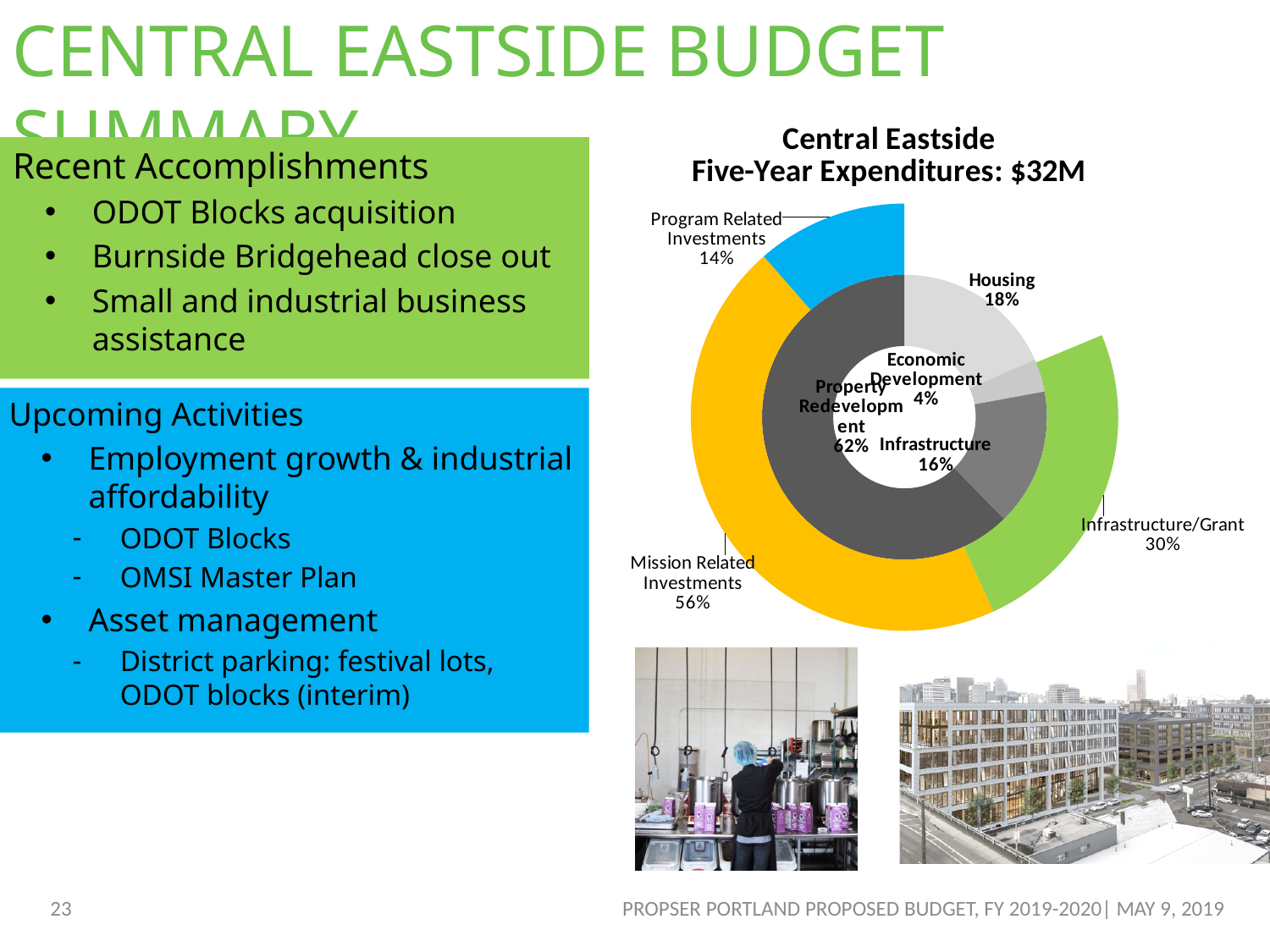
What percentage is shown for Property Redevelopment in the inner ring? 62% What share of the outer ring is Program Related Investments? 14% Which category in the outer ring has the largest share? Mission Related Investments What share of the outer ring is Mission Related Investments? 56% What share of the outer ring is Infrastructure/Grant? 30% What is the difference in percentage points between Infrastructure/Grant and Program Related Investments in the outer ring? 16 What is the title of the chart on the slide? Central Eastside Five-Year Expenditures: $32M What percentage is shown for Housing in the inner ring? 18% What kind of chart is shown on the slide? Doughnut chart Which is larger in the inner ring, Housing or Infrastructure? Housing Which category in the inner ring has the smallest share? Economic Development What percentage is shown for Economic Development in the inner ring? 4%